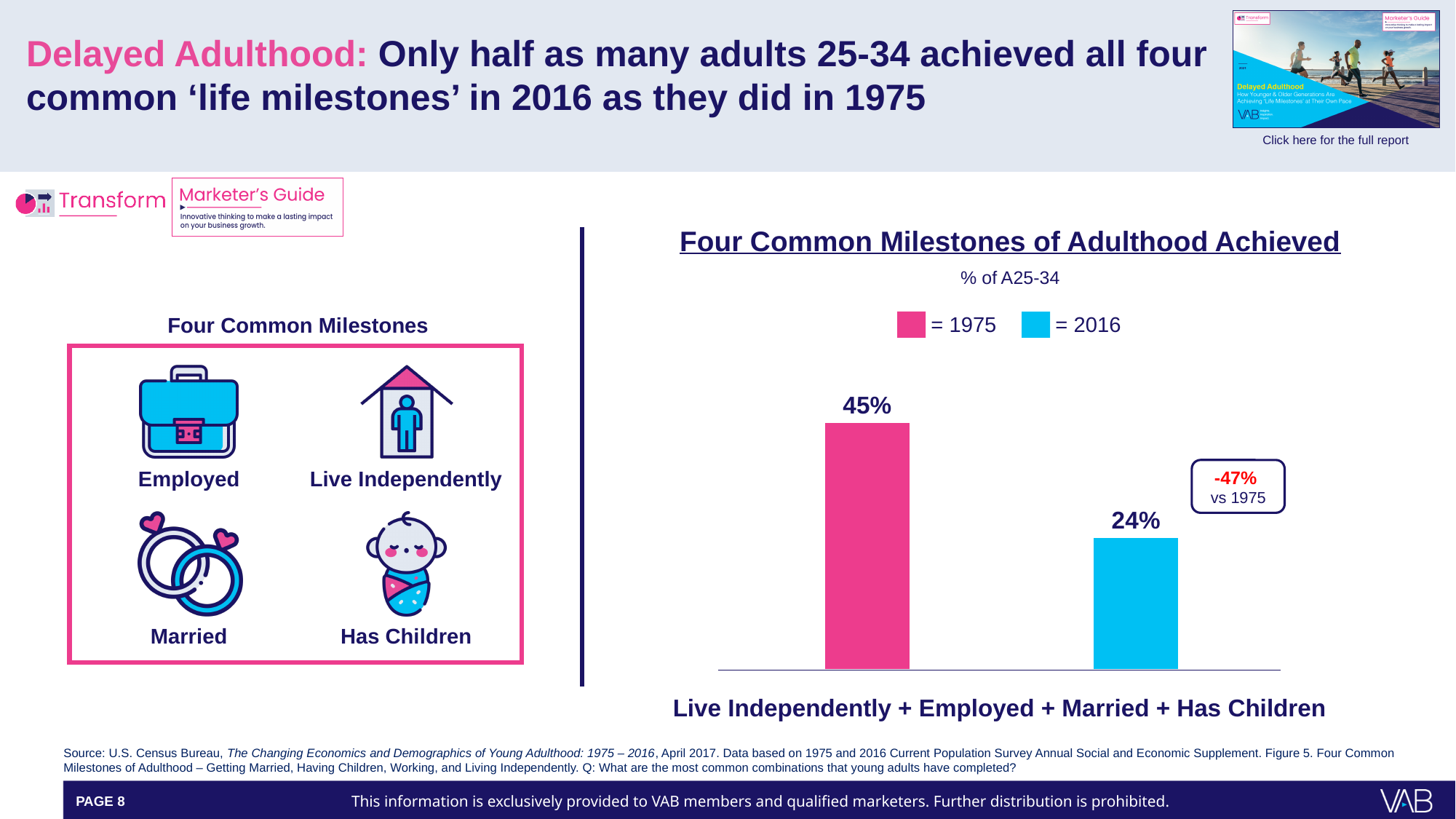
What is the difference in percentage points between the 1975 and 2016 values? 21 percentage points What percentage of adults 25-34 achieved all four common milestones in 1975? 45% What is the title of the chart? Four Common Milestones of Adulthood Achieved Does the value fall or rise from 1975 to 2016? Fall How many series does the legend list? 2 What percentage of adults 25-34 achieved all four common milestones in 2016? 24% Which year shows the lowest value in the chart? 2016 How many bars are plotted in the chart? 2 What percentage change vs 1975 is shown in the callout box? -47% What kind of chart is shown on the slide? Bar chart Which colour represents 2016 in the chart? Blue Which year has the higher bar, 1975 or 2016? 1975